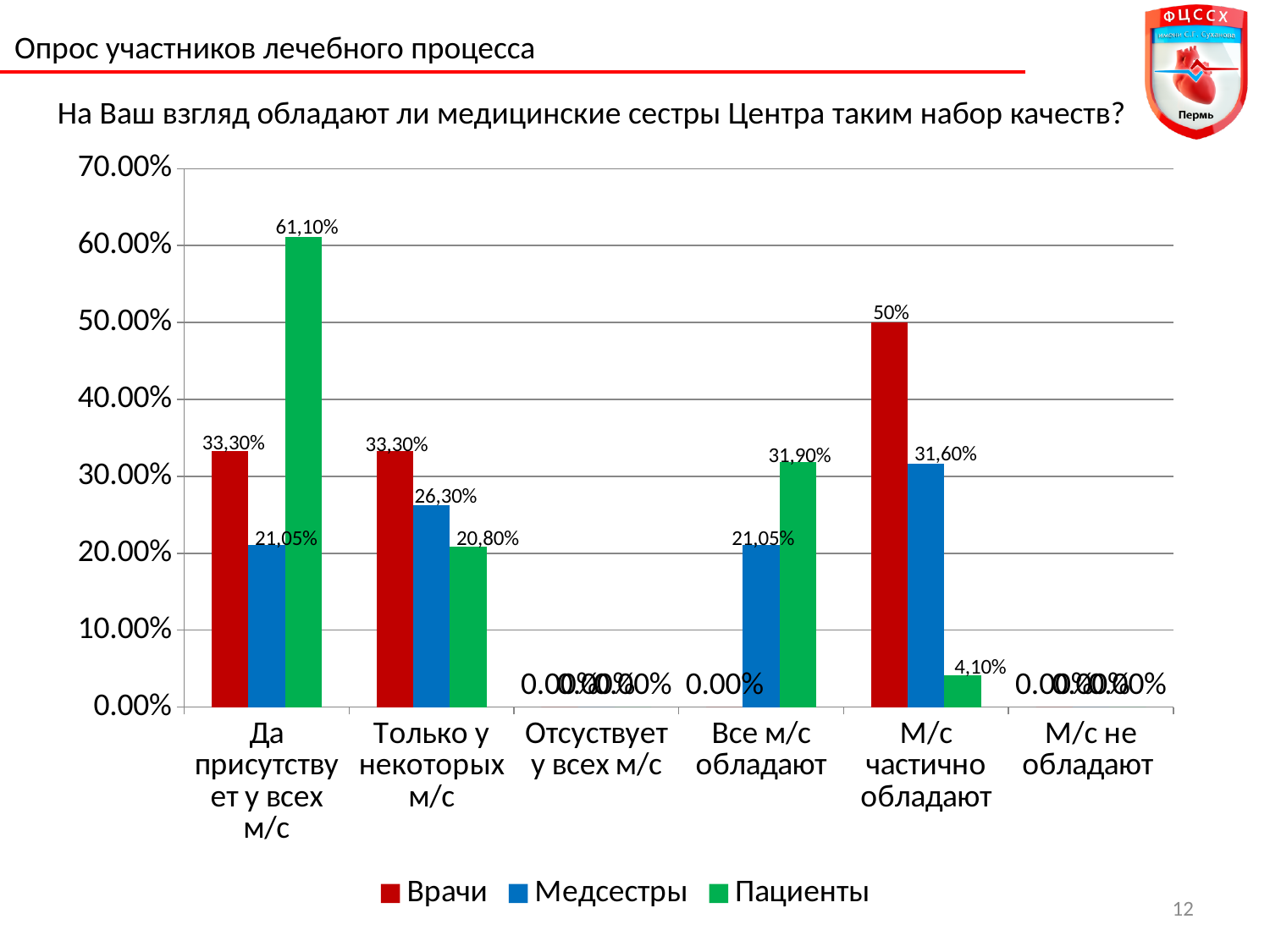
In the category 'Все м/с обладают', which series has the larger value, Медсестры or Пациенты? Пациенты Which series is shown in green in the legend? Пациенты What is the value for Пациенты in the category 'М/с частично обладают'? 4,10% What is the value for Пациенты in the category 'Да присутствует у всех м/с'? 61,10% How many categories are shown on the x axis? 6 How many series does the legend list? 3 What is the value for Медсестры in the category 'Только у некоторых м/с'? 26,30% What is the value for Врачи in the category 'М/с частично обладают'? 50% Which category has the highest value for the Пациенты series? Да присутствует у всех м/с Which category has the highest value for the Врачи series? М/с частично обладают What kind of chart is shown on the slide? bar chart What is the difference between the Пациенты and Врачи values in the category 'Да присутствует у всех м/с'? 27,80%